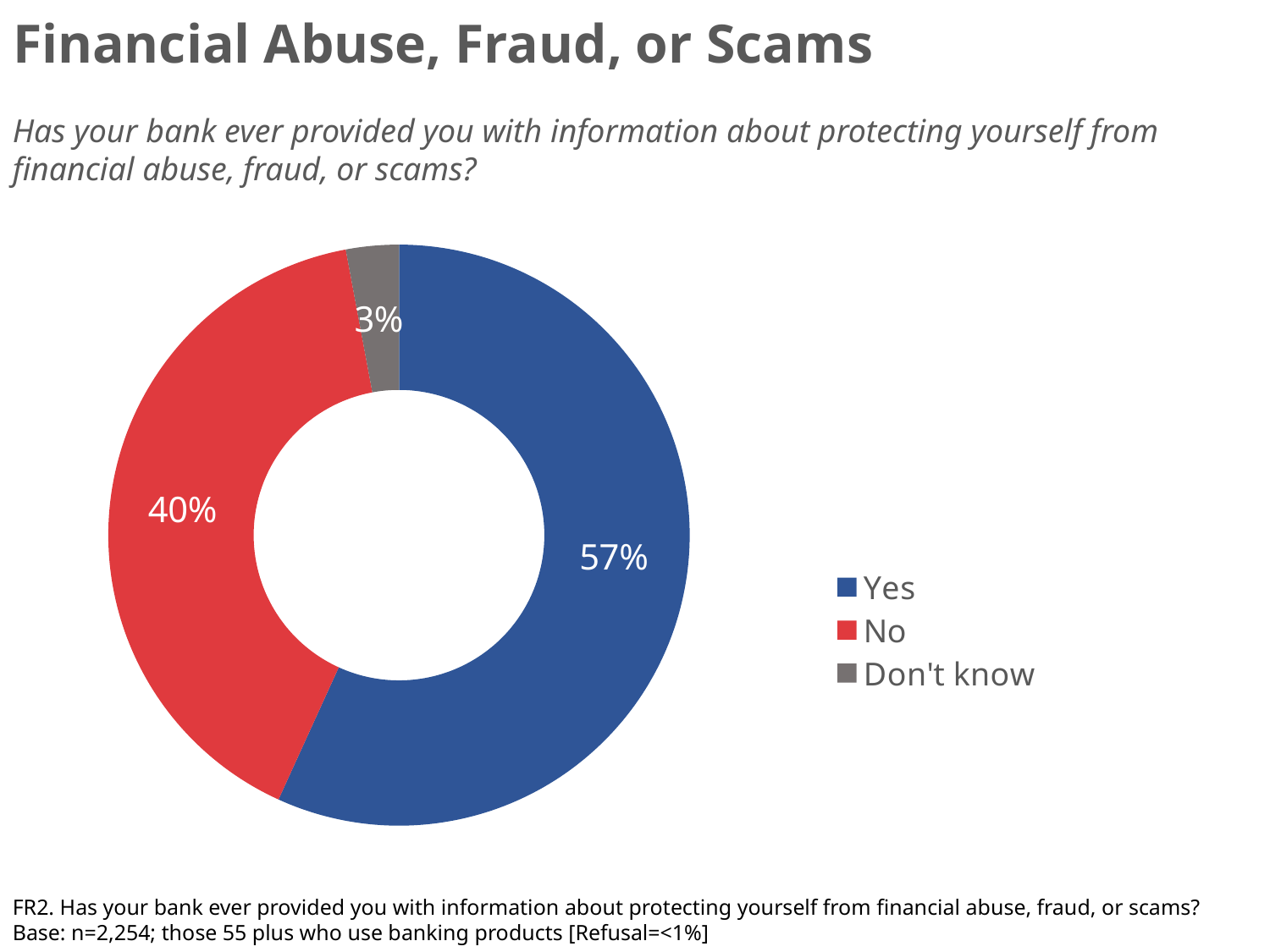
What colour is the "Yes" slice? Blue What percentage of respondents answered "No"? 40% What is the sample size (n) stated in the base note below the chart? 2,254 Which response has the smallest share of the chart? Don't know What percentage of respondents answered "Yes"? 57% What is the difference in percentage points between the "Yes" and "No" shares? 17 What percentage of respondents answered "Don't know"? 3% How many categories does the chart show? 3 What share of the pie does the "No" slice represent? 40% What kind of chart is shown on the slide? Pie chart (doughnut) Which response has the largest share of the chart? Yes Which is larger, the share for "No" or the share for "Don't know"? No